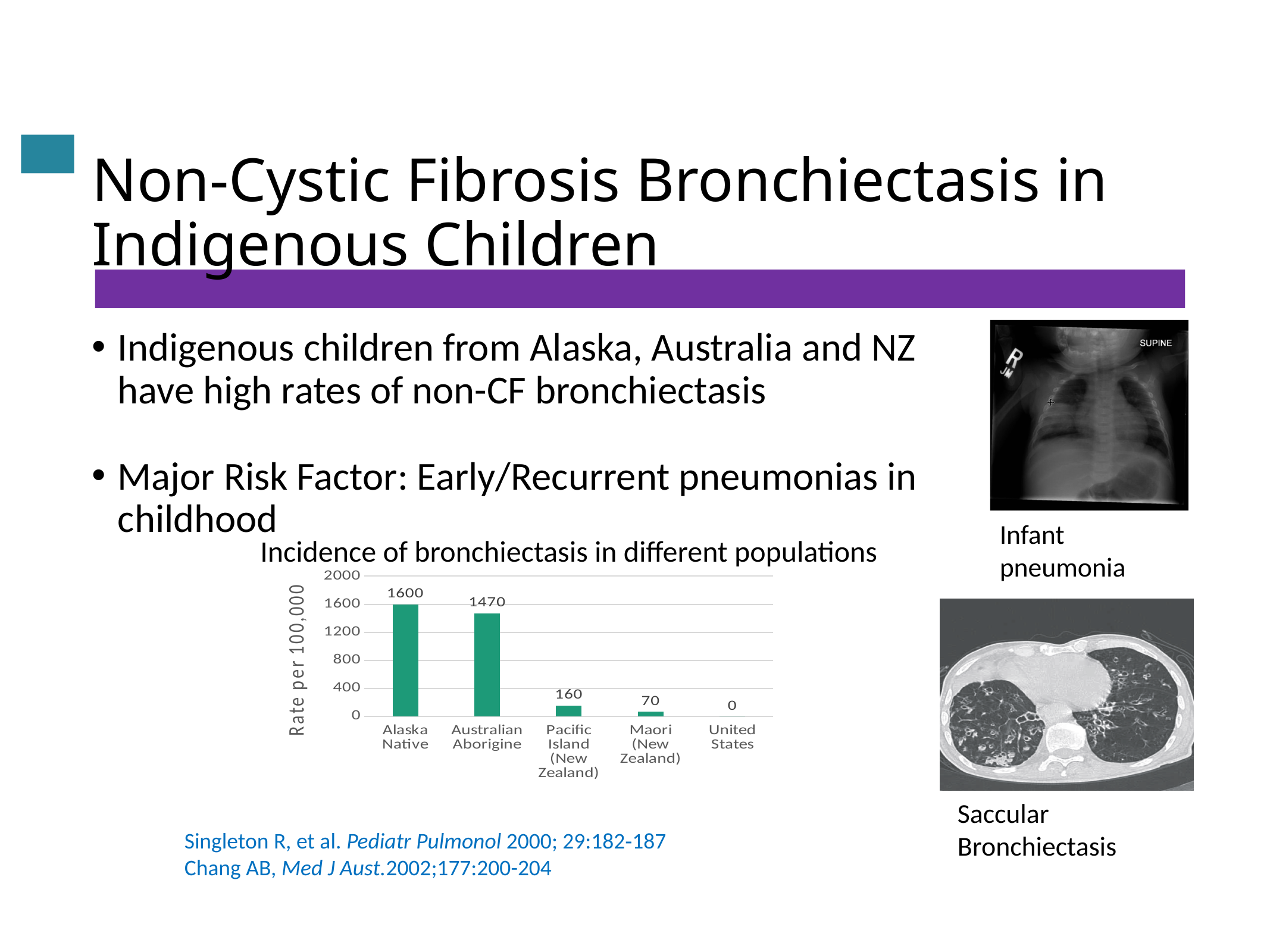
What kind of chart is shown on the slide? Bar chart What is the difference between the rates for Alaska Native and Australian Aborigine? 130 Which population has the lowest incidence of bronchiectasis? United States What is the rate per 100,000 for Alaska Native? 1600 What is the rate per 100,000 for Maori (New Zealand)? 70 How many populations are shown in the chart? 5 Which is larger, the rate for Pacific Island (New Zealand) or Maori (New Zealand)? Pacific Island (New Zealand) What is the rate per 100,000 for Pacific Island (New Zealand)? 160 What is the rate per 100,000 for Australian Aborigine? 1470 What is the title of the chart? Incidence of bronchiectasis in different populations Which population has the highest incidence of bronchiectasis? Alaska Native What is the rate per 100,000 for United States? 0